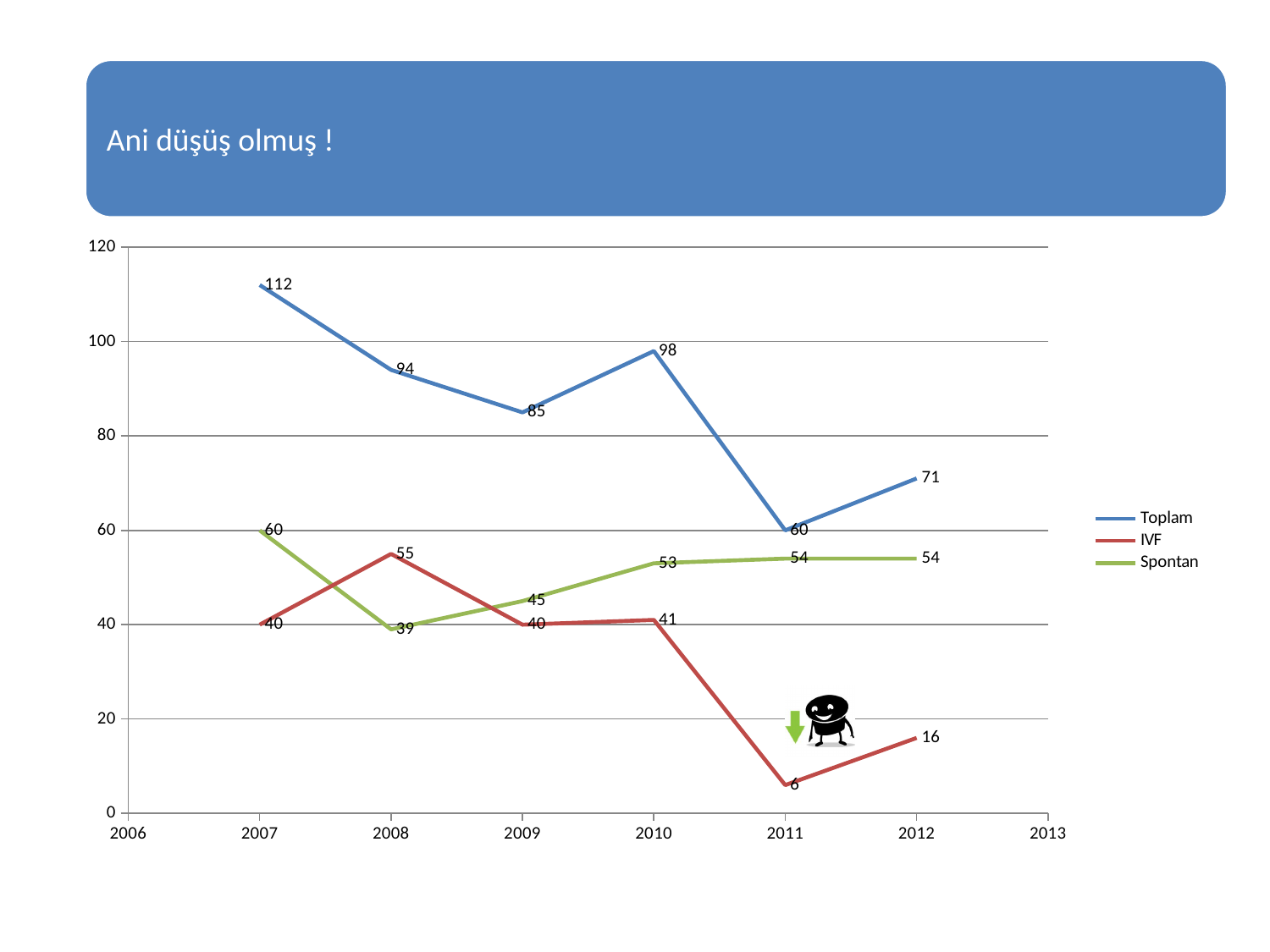
What type of chart is shown on the slide? line chart Does the Toplam series rise or fall from 2007 to 2009? fall In which year is the IVF series at its highest? 2008 Which series is drawn in green in the legend? Spontan What is the IVF value for 2011? 6 What is the difference between the Toplam values for 2010 and 2011? 38 What is the Spontan value for 2010? 53 What is the Toplam value for 2007? 112 How many data points are plotted for the Toplam series? 6 In which year is the Toplam series at its lowest? 2011 How many series does the legend list? 3 Which is larger in 2008, the IVF value or the Spontan value? IVF